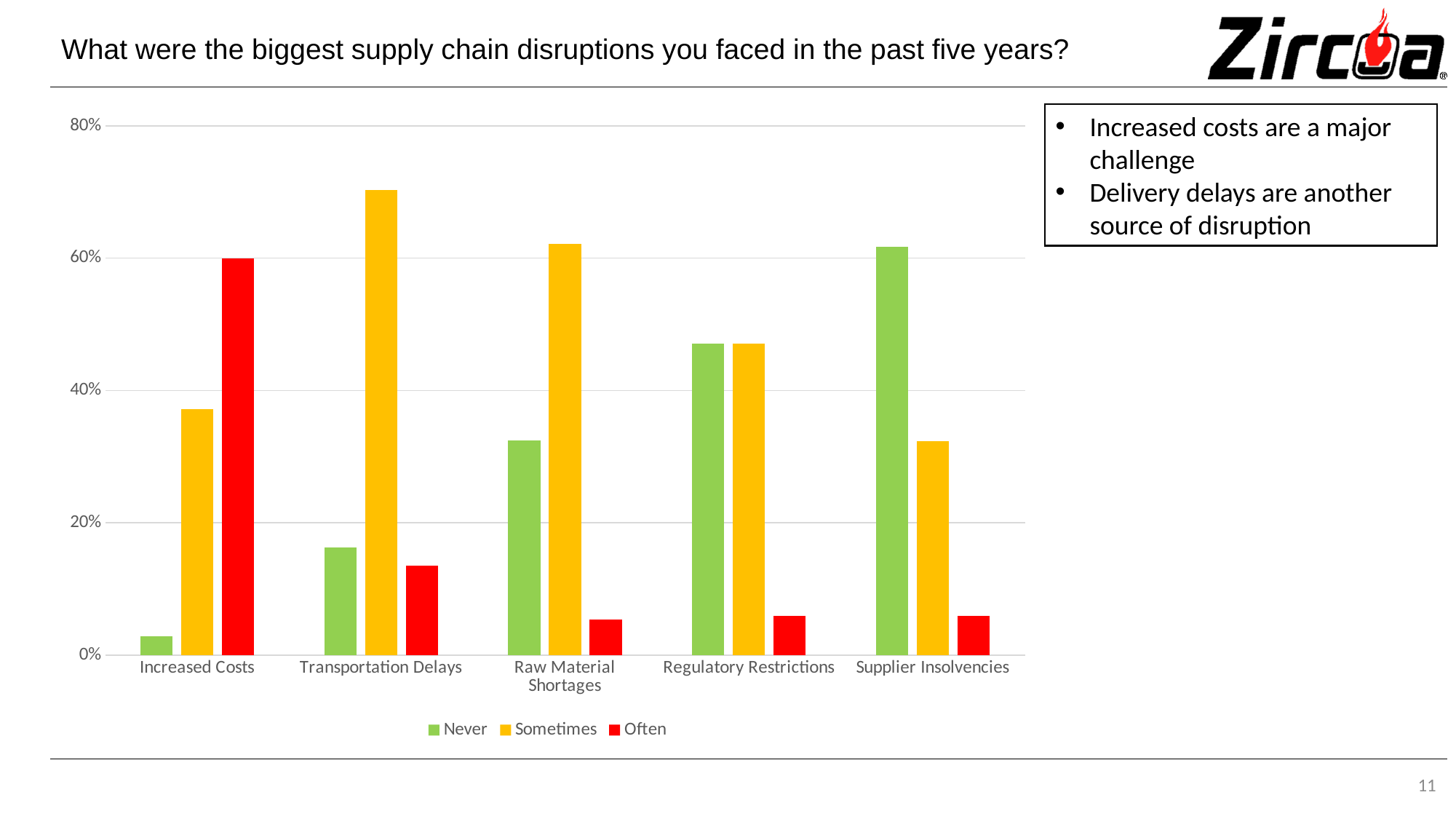
For Raw Material Shortages, which is larger: the Never value or the Sometimes value? Sometimes Which category has the highest value for the Often series? Increased Costs Which category has the highest value for the Sometimes series? Transportation Delays Which category has the lowest value for the Never series? Increased Costs What kind of chart is shown on the slide? bar chart Is the Never value for Increased Costs greater or less than 20%? less Which category has the highest value for the Never series? Supplier Insolvencies Which colour represents the Often series in the chart's legend? red How many series does the chart's legend list? 3 Is the Often value for Raw Material Shortages greater or less than 20%? less How many categories are shown on the x axis of the chart? 5 Is the Sometimes value for Transportation Delays greater or less than 60%? greater